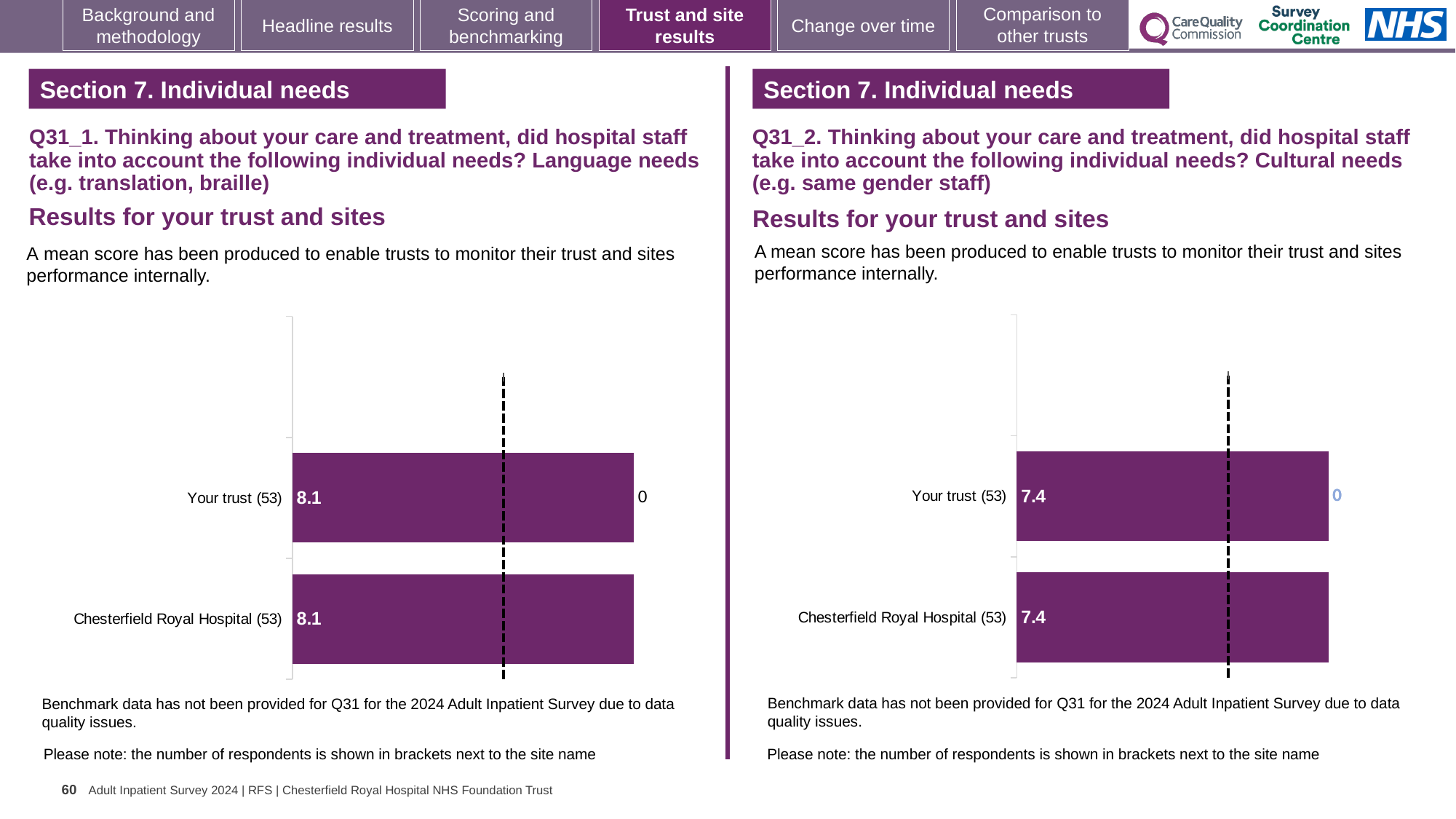
In the left chart (Q31_1, Language needs), what is the mean score for Chesterfield Royal Hospital? 8.1 What type of chart is used in the left chart (Q31_1, Language needs)? Bar chart In the left chart (Q31_1, Language needs), what is the difference between the scores for Your trust and Chesterfield Royal Hospital? 0 In the left chart (Q31_1, Language needs), what is the mean score for Your trust? 8.1 How many bars are plotted in the right chart (Q31_2, Cultural needs)? 2 In the right chart (Q31_2, Cultural needs), what is the difference between the scores for Your trust and Chesterfield Royal Hospital? 0 In the right chart (Q31_2, Cultural needs), what is the mean score for Chesterfield Royal Hospital? 7.4 In the left chart (Q31_1, Language needs), how many respondents are shown in brackets next to Chesterfield Royal Hospital? 53 In the right chart (Q31_2, Cultural needs), how many respondents are shown in brackets next to Your trust? 53 What type of chart is used in the right chart (Q31_2, Cultural needs)? Bar chart How many bars are plotted in the left chart (Q31_1, Language needs)? 2 In the right chart (Q31_2, Cultural needs), what is the mean score for Your trust? 7.4